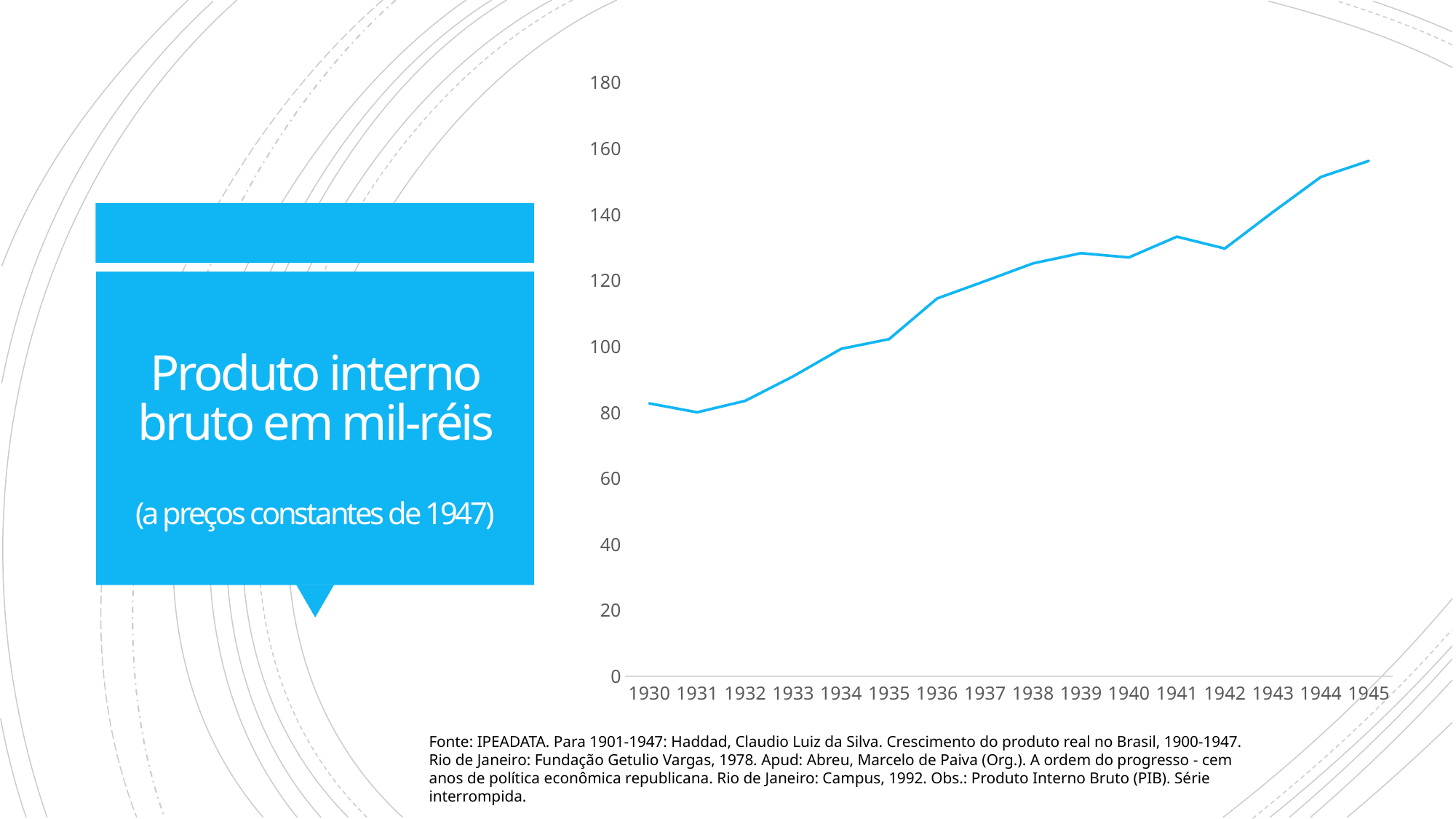
Which is larger, the value for 1943 or the value for 1939? 1943 Is the value for 1941 greater or less than 120? greater Which is larger, the value for 1930 or the value for 1945? 1945 Is the value for 1930 greater or less than 100? less What kind of chart is shown on the slide? line chart Is the value for 1936 greater or less than 100? greater How many years are plotted along the x axis of the chart? 16 What is the title shown in the blue box next to the chart? Produto interno bruto em mil-réis (a preços constantes de 1947) Overall, do the values rise or fall from 1930 to 1945? rise Which year has the highest value in the chart? 1945